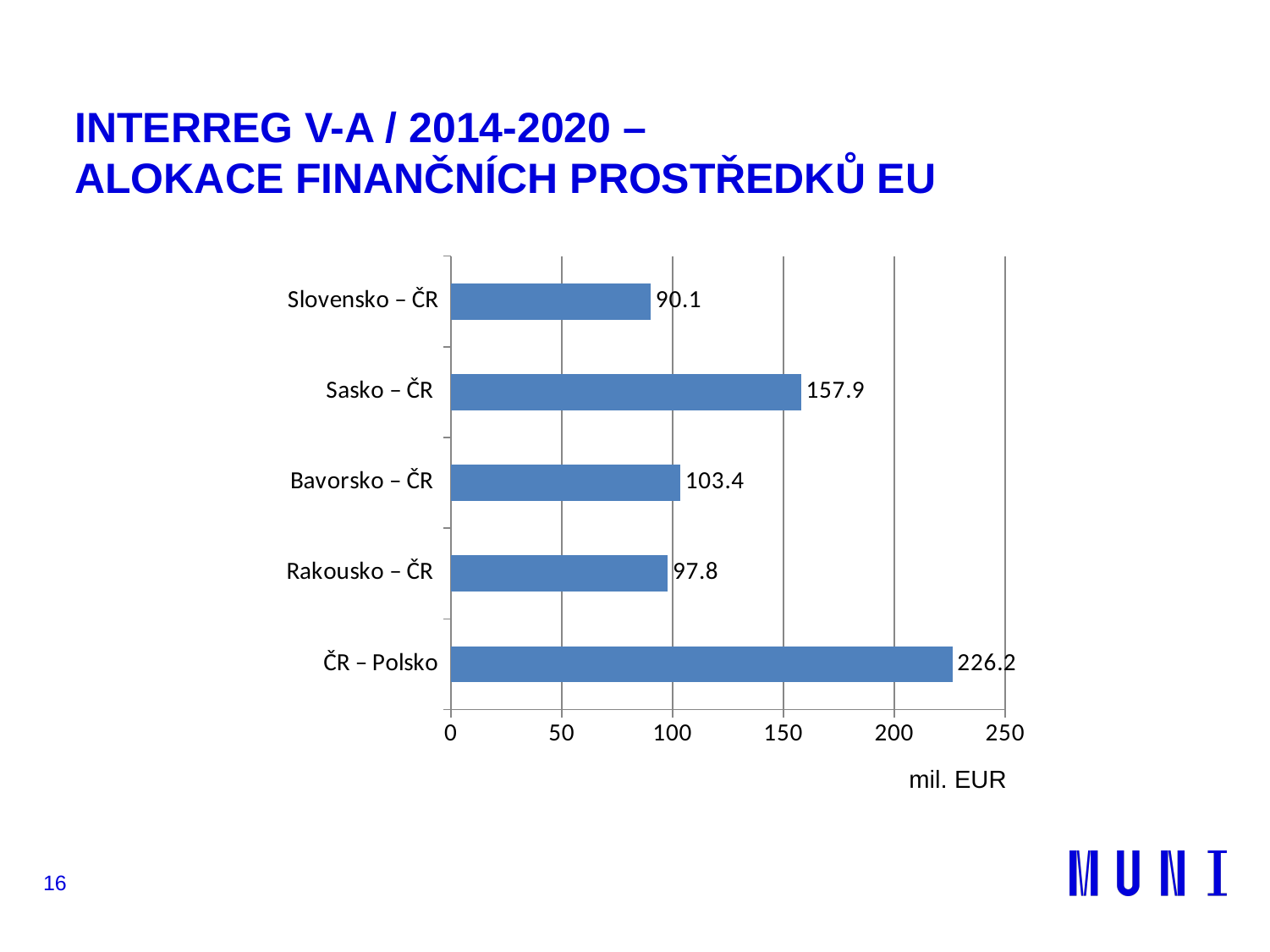
What kind of chart is shown on the slide? bar chart Which category has the highest value? ČR – Polsko Is the value for Sasko – ČR greater or less than 150? greater What is the difference between the values for Bavorsko – ČR and Rakousko – ČR? 5.6 What is the value for ČR – Polsko? 226.2 What is the value for Rakousko – ČR? 97.8 What is the value for Sasko – ČR? 157.9 Which category has the lowest value? Slovensko – ČR What is the difference between the values for ČR – Polsko and Sasko – ČR? 68.3 How many categories are shown in the chart? 5 Which is larger, the value for Bavorsko – ČR or the value for Slovensko – ČR? Bavorsko – ČR What is the value for Slovensko – ČR? 90.1